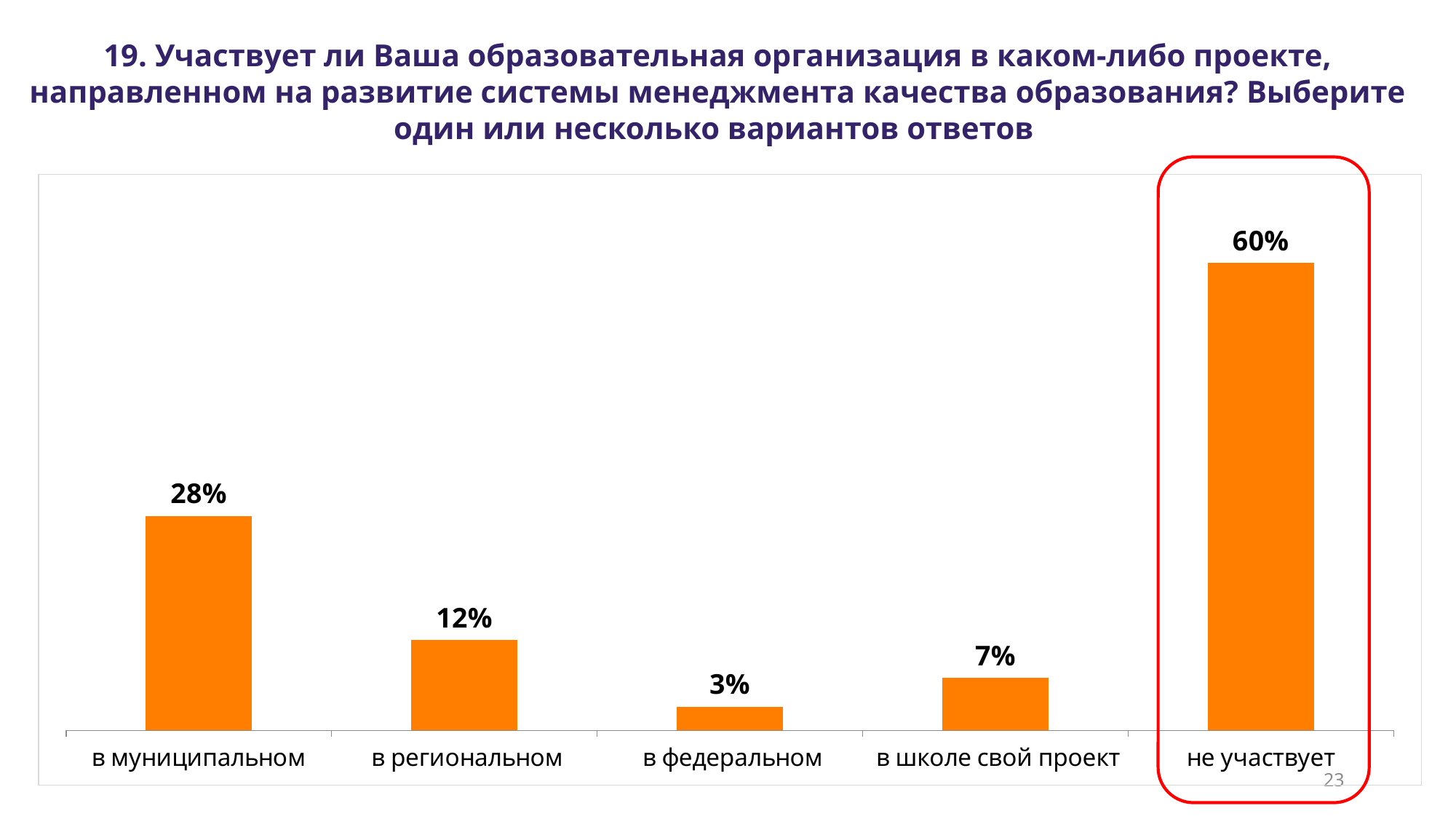
Which category has the lowest value? в федеральном Which category has the highest value? не участвует What is the value for «в школе свой проект»? 7% What is the difference between the values for «не участвует» and «в муниципальном»? 32% How many categories are shown on the chart? 5 Which category on the chart is outlined with a red rounded rectangle? не участвует What is the value for «не участвует»? 60% What is the value for «в региональном»? 12% What is the value for «в муниципальном»? 28% Which is larger, the value for «в региональном» or «в школе свой проект»? в региональном What kind of chart is shown on the slide? bar chart What is the value for «в федеральном»? 3%